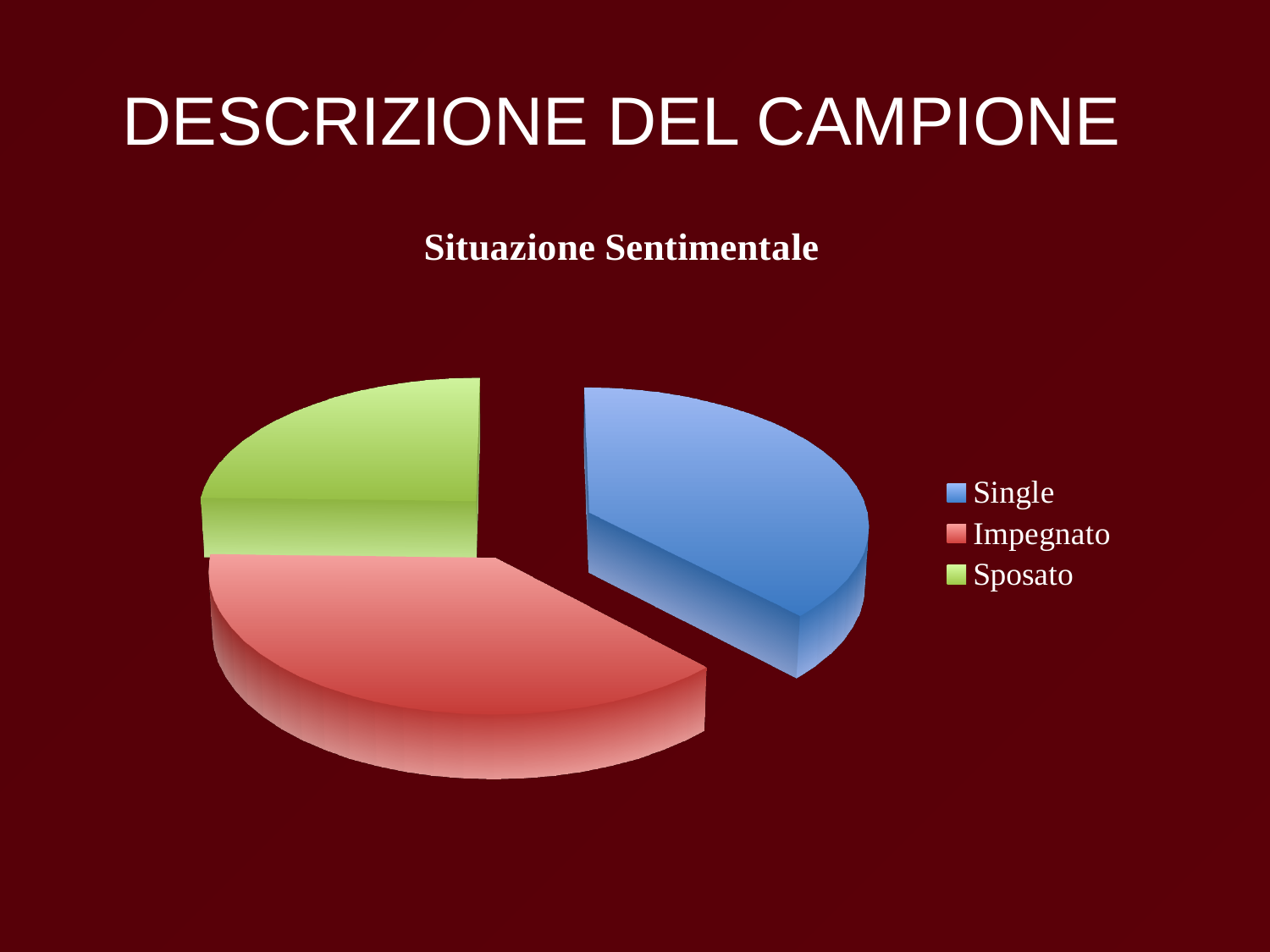
What is the title of the chart? Situazione Sentimentale Which slice is larger, Single or Sposato? Single Which colour represents the Sposato category in the chart? green Which category has the smallest slice of the pie? Sposato How many slices does the pie chart have? 3 How many entries does the legend list? 3 What kind of chart is shown on the slide? pie chart